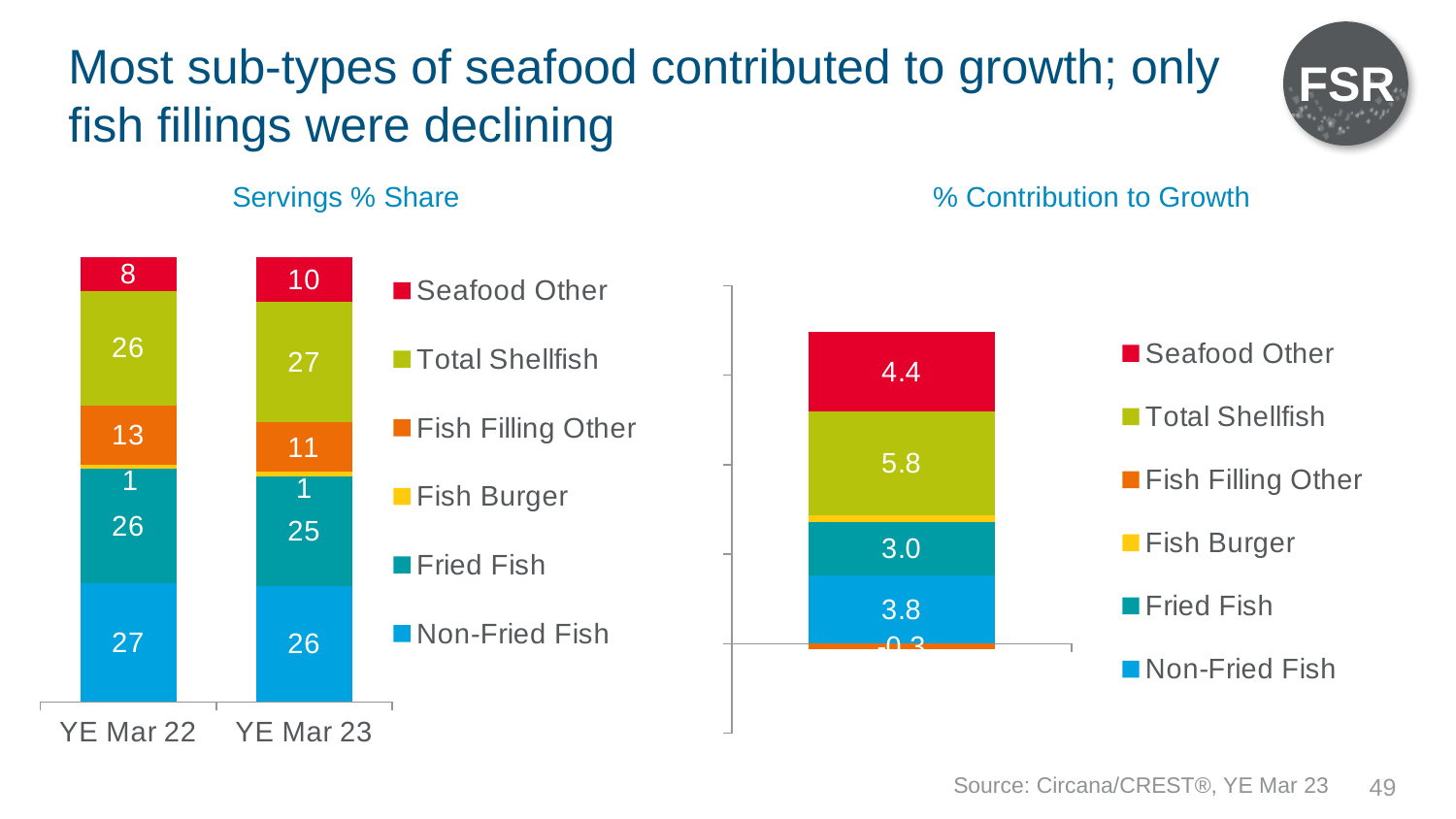
In the Servings % Share chart, what is the value for Seafood Other in YE Mar 23? 10 In the % Contribution to Growth chart, which series has the highest contribution? Total Shellfish In the % Contribution to Growth chart, what is the value for Total Shellfish? 5.8 In the Servings % Share chart, what is the difference between the Fish Filling Other values for YE Mar 22 and YE Mar 23? 2 What kind of chart is the % Contribution to Growth chart? Stacked bar chart In the Servings % Share chart, which is larger: Total Shellfish in YE Mar 22 or Total Shellfish in YE Mar 23? YE Mar 23 In the Servings % Share chart, how many categories are shown on the x axis? 2 In the Servings % Share chart, what is the total of the YE Mar 23 stacked bar? 100 In the Servings % Share chart, what is the value for Non-Fried Fish in YE Mar 22? 27 In the % Contribution to Growth chart, what is the value for Fried Fish? 3.0 In the Servings % Share chart, what is the value for Fish Filling Other in YE Mar 22? 13 In the Servings % Share chart, how many series does the legend list? 6